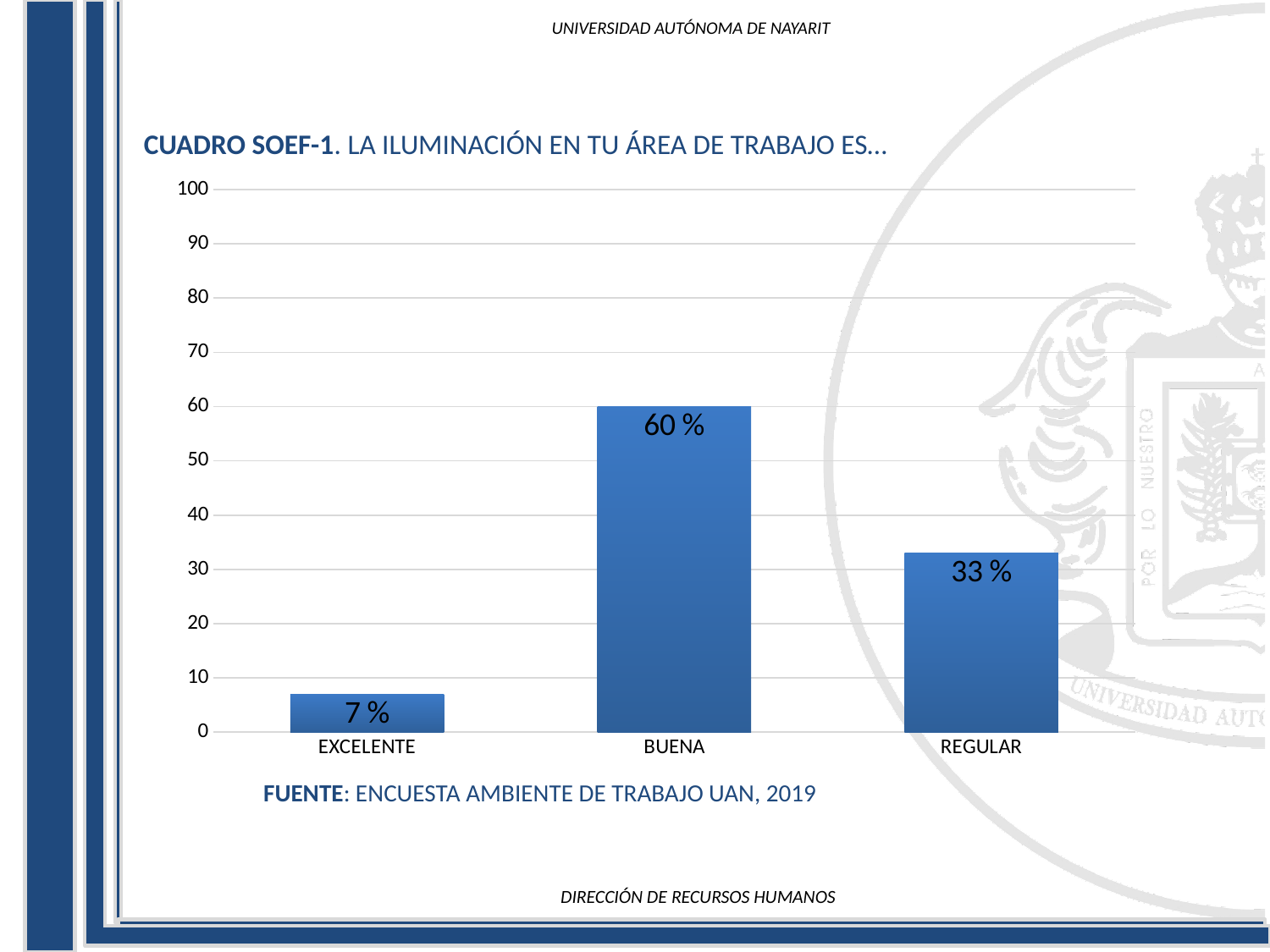
What kind of chart is shown on the slide? bar chart How many categories are shown on the x axis? 3 What source is cited below the chart? ENCUESTA AMBIENTE DE TRABAJO UAN, 2019 What is the value for EXCELENTE? 7 % Which category has the highest value? BUENA What is the difference between the values for REGULAR and EXCELENTE? 26 % Which is larger, the value for REGULAR or the value for EXCELENTE? REGULAR Which category has the lowest value? EXCELENTE Is the value for BUENA greater or less than 50? greater What is the value for BUENA? 60 % What is the difference between the values for BUENA and REGULAR? 27 % What is the value for REGULAR? 33 %